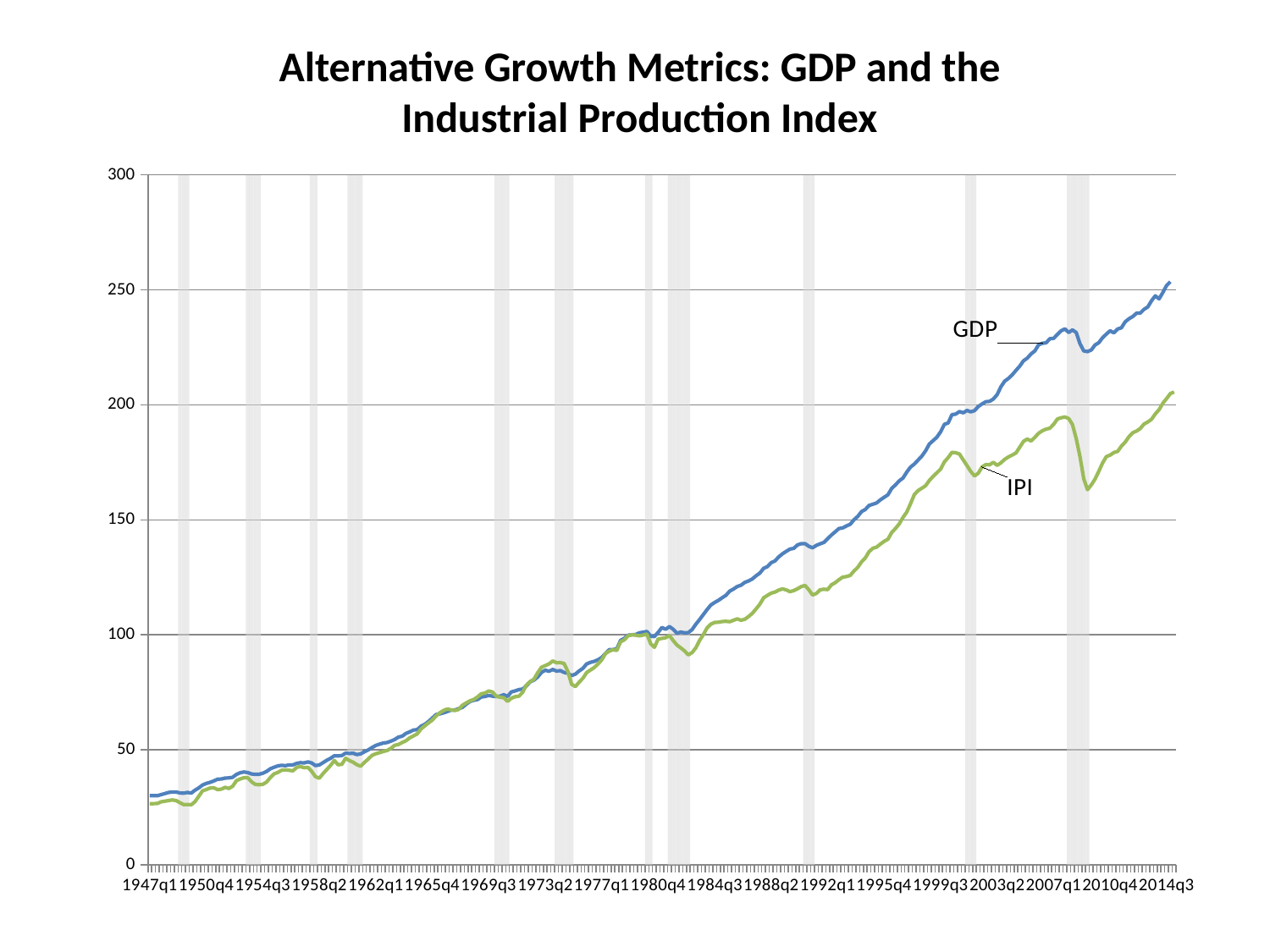
Is the value for IPI at 1947q1 greater or less than 50? less Is the value for IPI at 2010q4 greater or less than 150? greater Is the value for IPI at 2014q3 greater or less than 250? less Do the IPI values generally rise or fall from 1947q1 to 2014q3? rise What is the title of the chart? Alternative Growth Metrics: GDP and the Industrial Production Index How many series are plotted on the chart? 2 Do the GDP values generally rise or fall from 1947q1 to 2014q3? rise Which series is labelled with the blue line? GDP At 2014q3, which series has the higher value, GDP or IPI? GDP What kind of chart is shown on the slide? line chart